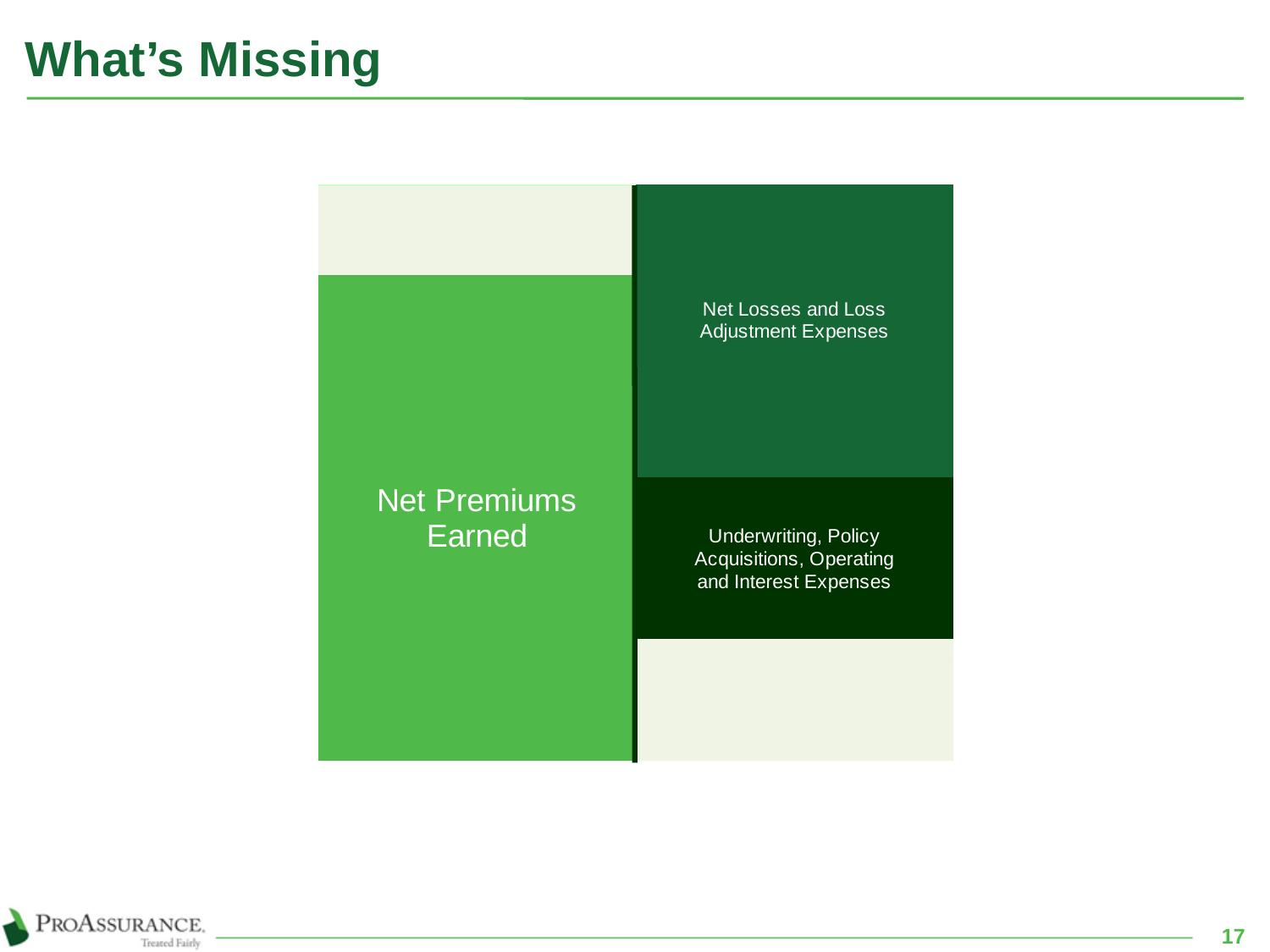
How many labelled segments make up the right bar of the chart? 2 What is the label on the left bar of the chart? Net Premiums Earned What is the title of the slide containing the chart? What's Missing Which segment is at the top of the right bar? Net Losses and Loss Adjustment Expenses What kind of chart is shown on the slide? Stacked bar chart Which segment of the right bar is larger: Net Losses and Loss Adjustment Expenses or Underwriting, Policy Acquisitions, Operating and Interest Expenses? Net Losses and Loss Adjustment Expenses How many bars are shown in the chart? 2